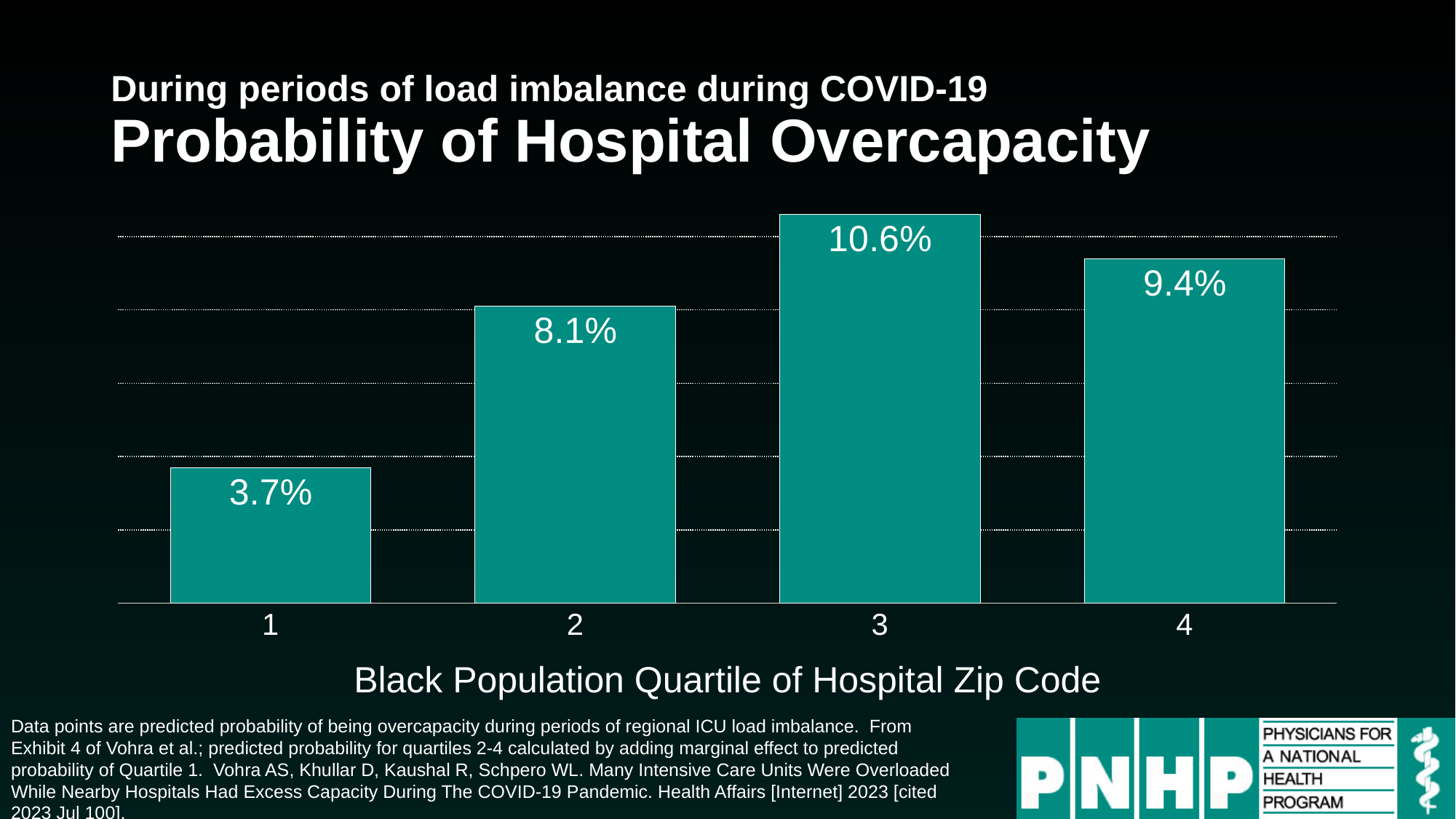
What is the difference in probability of hospital overcapacity between quartile 2 and quartile 1? 4.4% What is the probability of hospital overcapacity for quartile 2? 8.1% What is the difference in probability of hospital overcapacity between quartile 3 and quartile 1? 6.9% Which Black population quartile has the highest probability of hospital overcapacity? 3 What kind of chart is shown on the slide? Bar chart Which has a higher probability of hospital overcapacity, quartile 3 or quartile 4? Quartile 3 What is the probability of hospital overcapacity for quartile 3? 10.6% What is the probability of hospital overcapacity for quartile 4? 9.4% Which Black population quartile has the lowest probability of hospital overcapacity? 1 What is the probability of hospital overcapacity for quartile 1? 3.7% How many quartiles are shown on the x axis of the chart? 4 What is the x-axis label of the chart? Black Population Quartile of Hospital Zip Code